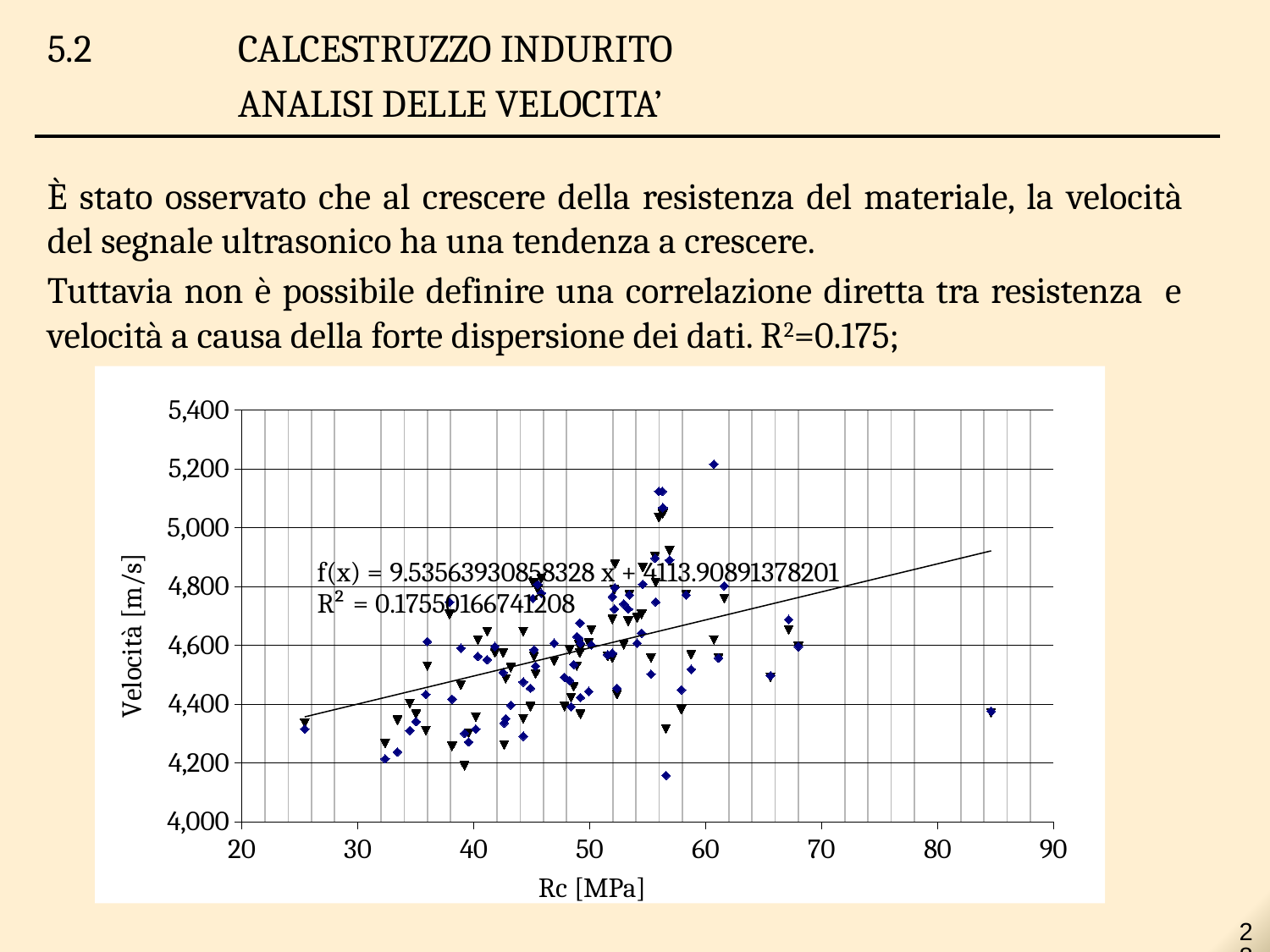
What is the maximum value shown on the y axis of the chart? 5,400 What kind of chart is shown on the slide? Scatter plot What is the label of the x axis of the chart? Rc [MPa] What is the label of the y axis of the chart? Velocità [m/s] According to the trendline, do the velocity values rise or fall as Rc increases? Rise Is the Rc value of the rightmost data point on the chart greater or less than 80 MPa? greater What is the slope coefficient of x in the trendline equation printed on the chart? 9.53563930858328 Is the velocity of the highest data point on the chart greater or less than 5,000 m/s? greater What is the constant term in the trendline equation printed on the chart? 4113.90891378201 Is the velocity of the lowest data point on the chart greater or less than 4,200 m/s? less